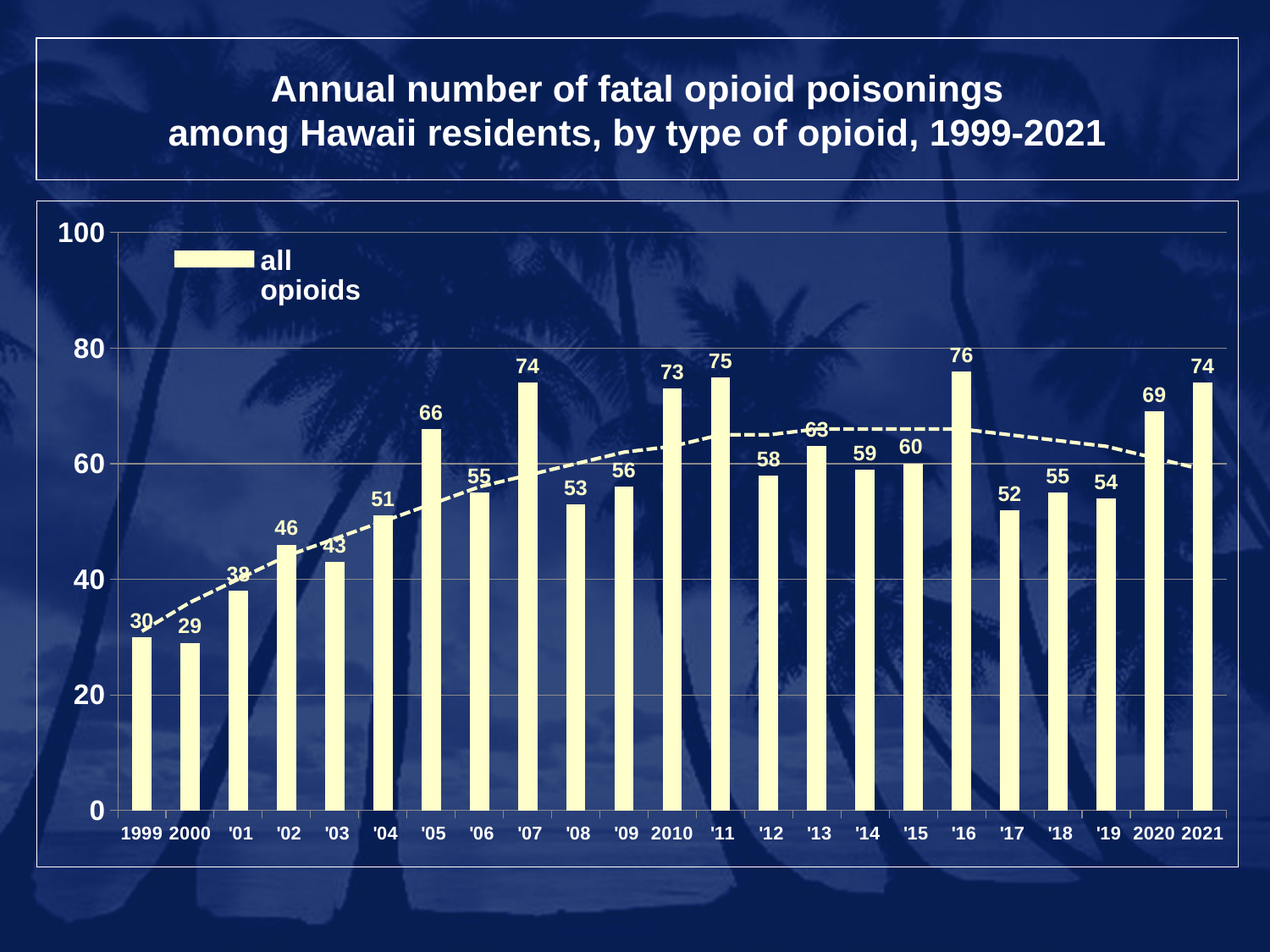
Which year has the lowest number of fatal opioid poisonings? 2000 What is the number of fatal opioid poisonings in 2021? 74 Which is larger, the value for '07 or the value for '08? '07 How many years are shown on the x axis? 23 What kind of chart is shown on the slide? combination bar and line chart What is the number of fatal opioid poisonings in 2016? 76 Is the value for '05 greater or less than 60? greater What is the difference between the values for 2020 and '19? 15 Which year has the highest number of fatal opioid poisonings? '16 What is the number of fatal opioid poisonings in 1999? 30 How many series does the legend list? 1 Do the values rise or fall from 1999 to '07? rise